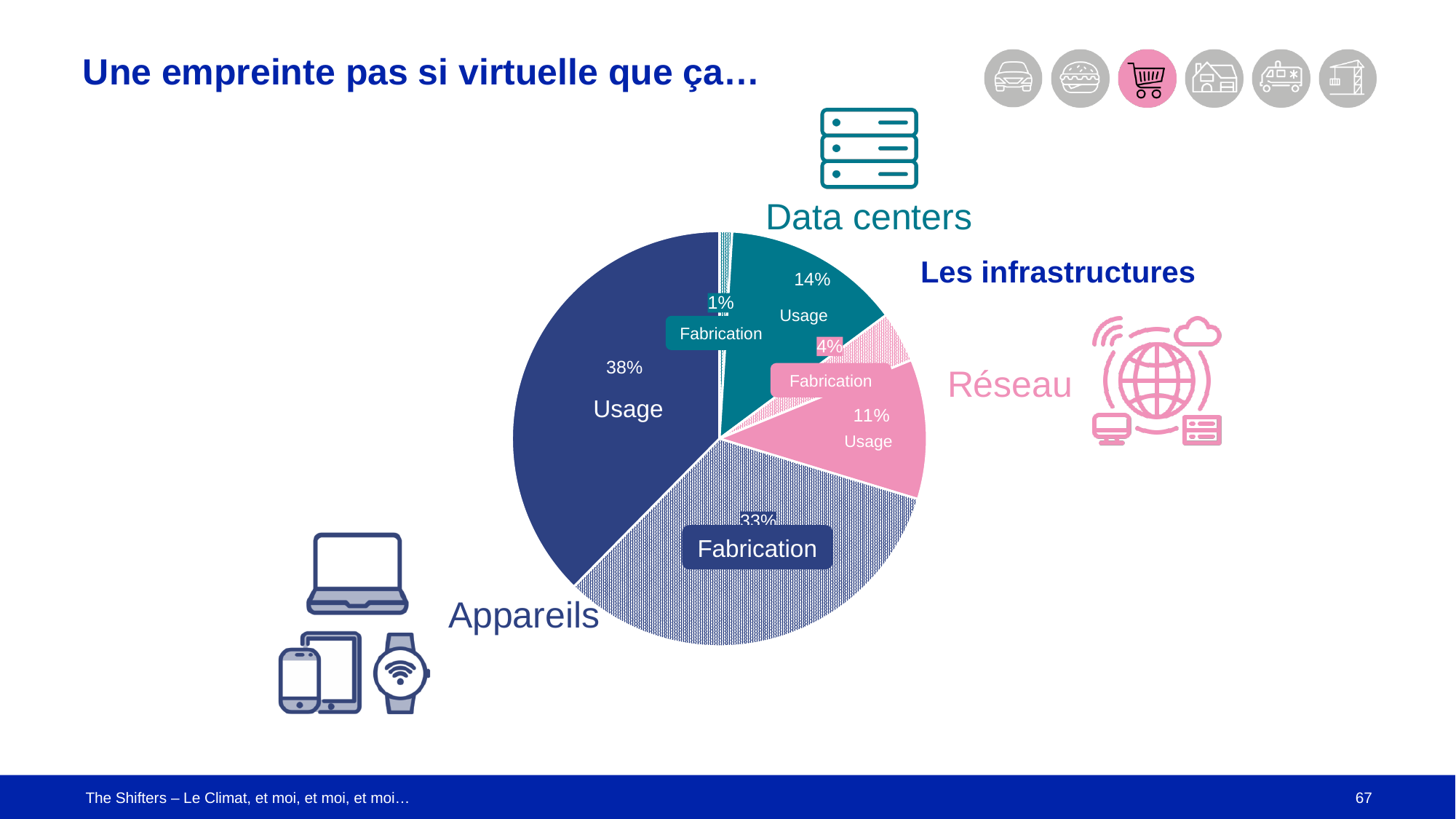
What percentage is shown for the Fabrication slice of Appareils? 33% Which slice of the pie chart is the smallest? Data centers Fabrication (1%) Which slice of the pie chart is the largest? Appareils Usage (38%) What percentage is shown for the Fabrication slice of Réseau? 4% How many slices does the pie chart have? 6 How many percentage points larger is the Appareils Usage slice than the Appareils Fabrication slice? 5 percentage points What type of chart is shown on the slide? Pie chart What share of the pie does the Usage slice for Appareils represent? 38% What percentage is shown for the Usage slice of Réseau? 11% Which is larger: the Usage slice for Data centers or the Usage slice for Réseau? Data centers Usage What percentage is shown for the Usage slice of Data centers? 14% What percentage is shown for the Fabrication slice of Data centers? 1%